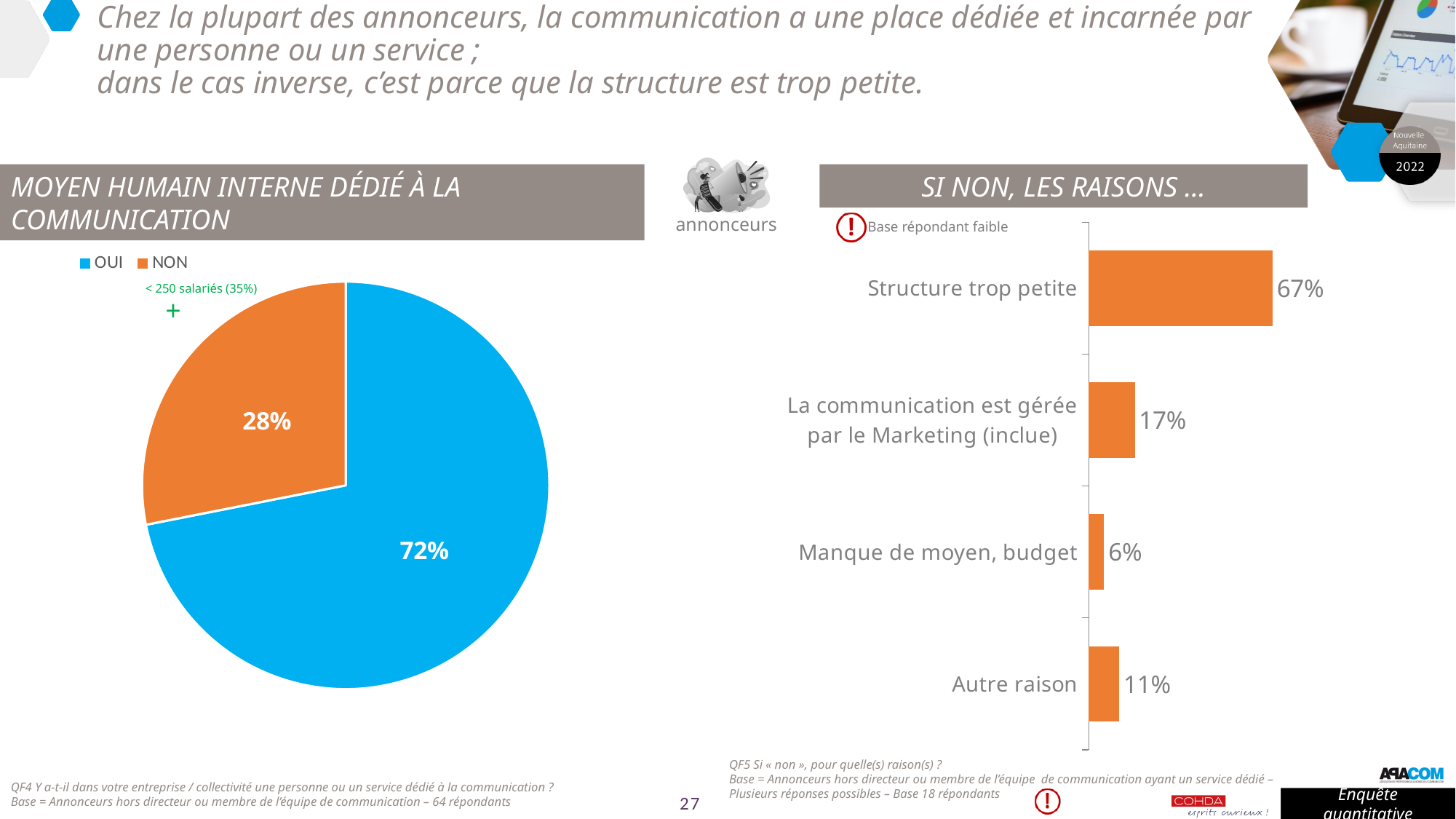
In the chart 'SI NON, LES RAISONS ...', what is the value for 'La communication est gérée par le Marketing (inclue)'? 17% What kind of chart is 'SI NON, LES RAISONS ...'? Bar chart In the pie chart 'MOYEN HUMAIN INTERNE DÉDIÉ À LA COMMUNICATION', what is the difference between the OUI and NON shares? 44 percentage points In the chart 'SI NON, LES RAISONS ...', how many reasons are shown? 4 In the chart 'SI NON, LES RAISONS ...', what is the value for 'Structure trop petite'? 67% In the pie chart 'MOYEN HUMAIN INTERNE DÉDIÉ À LA COMMUNICATION', how many entries does the legend list? 2 In the pie chart 'MOYEN HUMAIN INTERNE DÉDIÉ À LA COMMUNICATION', what share of respondents answered NON? 28% In the chart 'SI NON, LES RAISONS ...', what is the difference between 'Structure trop petite' and 'Autre raison'? 56 percentage points In the pie chart 'MOYEN HUMAIN INTERNE DÉDIÉ À LA COMMUNICATION', which colour represents OUI? Blue In the chart 'SI NON, LES RAISONS ...', which reason has the lowest value? Manque de moyen, budget In the pie chart 'MOYEN HUMAIN INTERNE DÉDIÉ À LA COMMUNICATION', what share of respondents answered OUI? 72% In the chart 'SI NON, LES RAISONS ...', which reason has the highest value? Structure trop petite